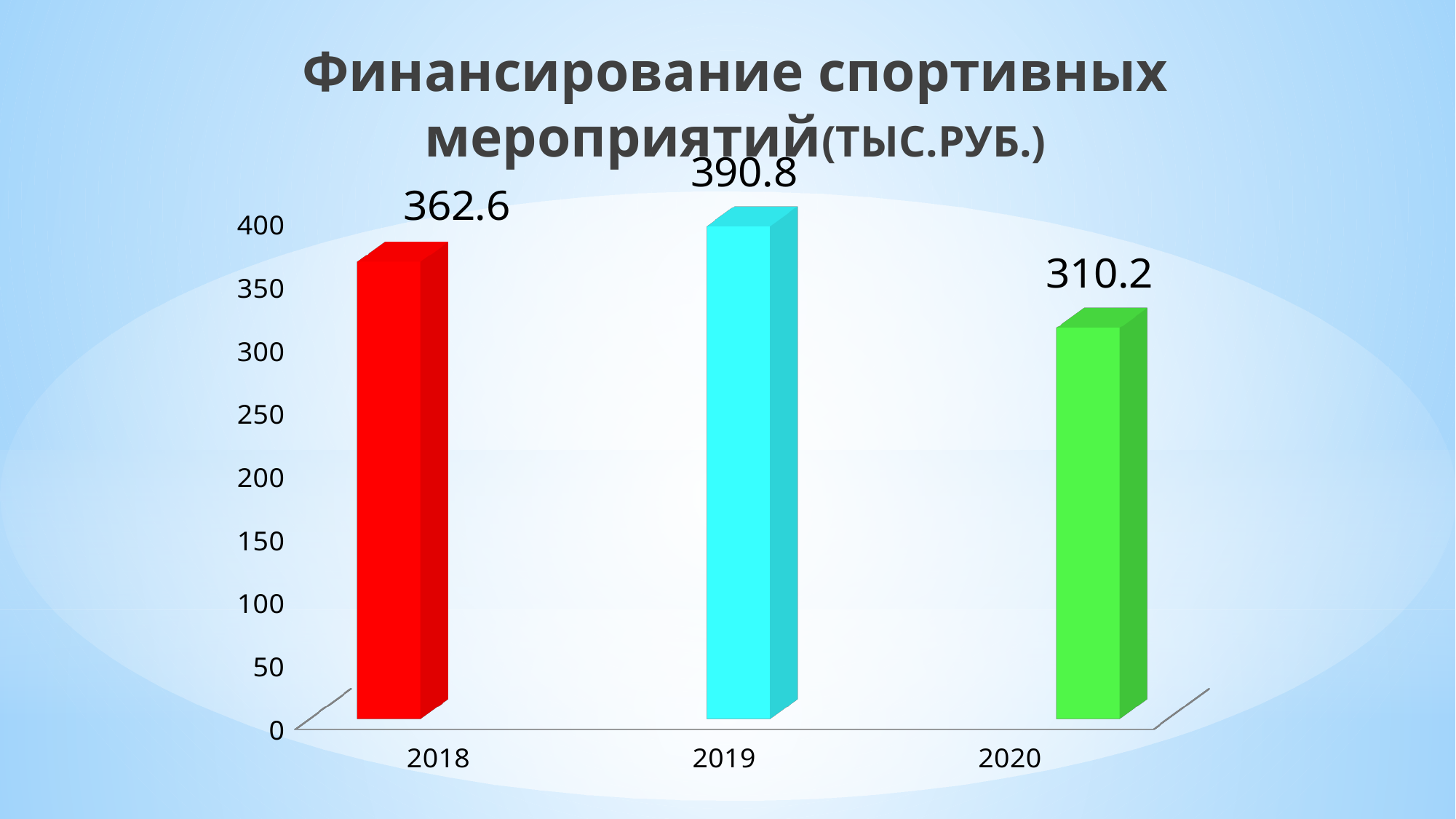
Which is larger, the value for 2018 or the value for 2020? 2018 How many years are shown on the chart? 3 What kind of chart is shown on the slide? bar chart What colour is the bar for 2019? cyan What is the difference between the values for 2019 and 2018? 28.2 What is the value for 2019? 390.8 Which year has the highest value? 2019 Is the value for 2020 greater or less than 350? less What is the value for 2020? 310.2 What is the difference between the values for 2018 and 2020? 52.4 Which year has the lowest value? 2020 What is the value for 2018? 362.6